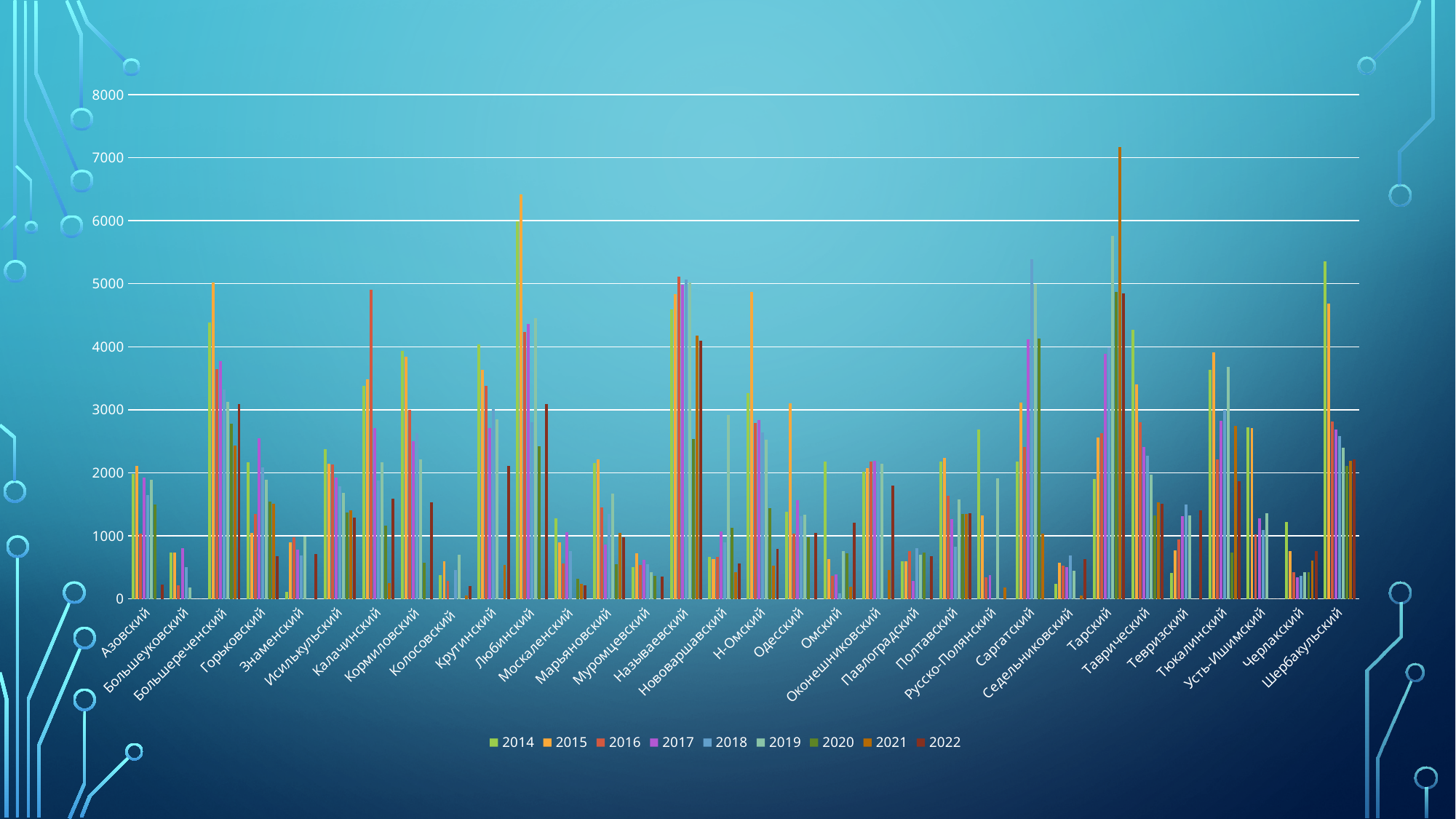
Is the value for Тарский in 2021 greater or less than 7000? greater What is the first year listed in the legend? 2014 How many categories are shown along the x axis? 32 Is the value for Шербакульский in 2014 greater or less than 5000? greater For Тарский, which series has the tallest bar? 2021 Is the value for Любинский in 2015 greater or less than 6000? greater Which is larger for Тарский: the 2021 value or the 2014 value? 2021 What kind of chart is shown on the slide? bar chart How many series does the legend list? 9 Which category contains the tallest bar on the chart? Тарский For Любинский, which series has the tallest bar? 2015